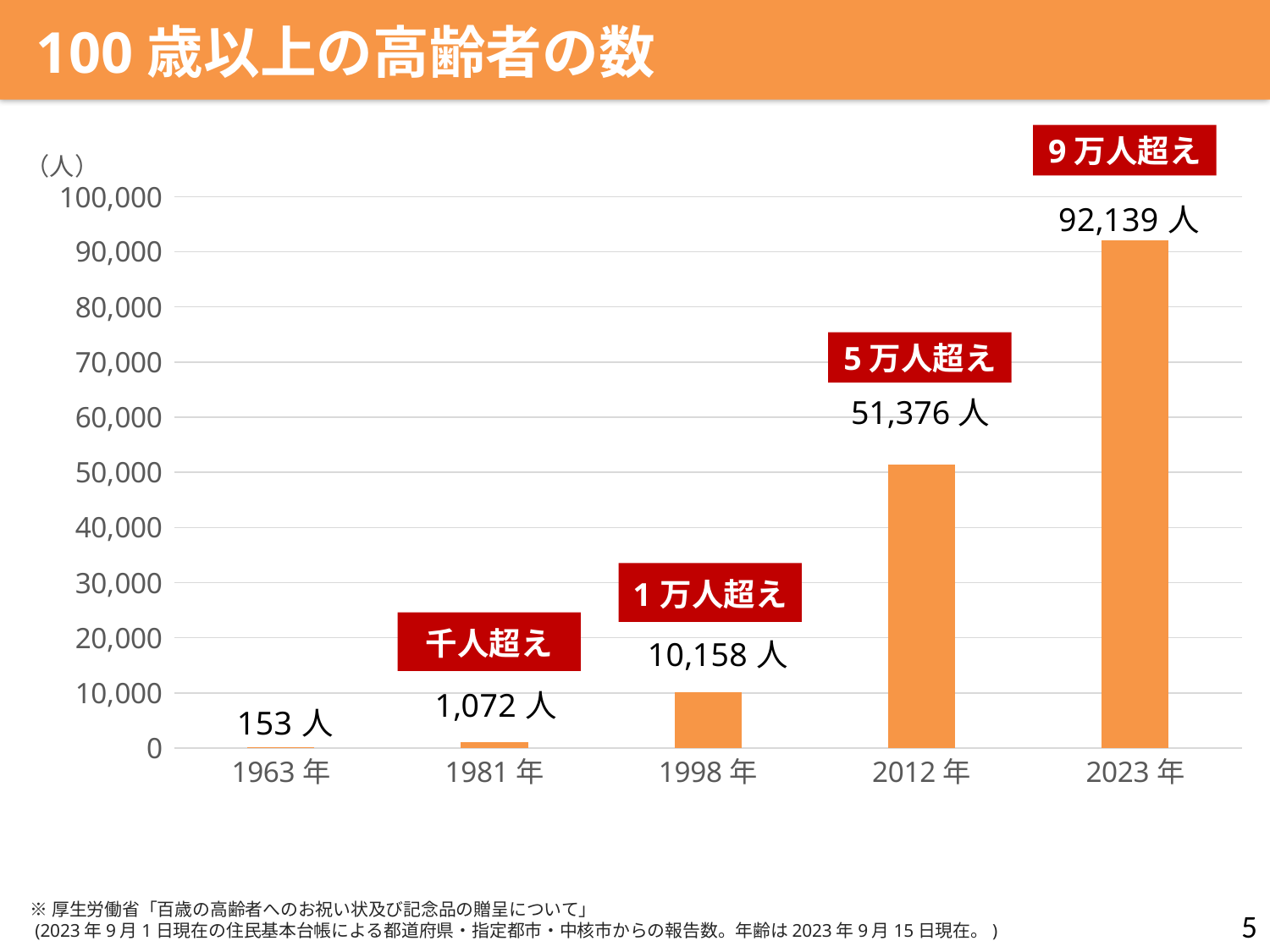
Do the values rise or fall from 1963年 to 2023年? rise What is the value for 1998年? 10,158 人 Which is larger, the value for 2012年 or the value for 1998年? 2012年 What kind of chart is this? bar chart What is the value for 1963年? 153 人 What is the difference between the values for 1998年 and 1981年? 9,086 人 How many years are shown on the x axis? 5 Which year has the lowest value? 1963年 Which year has the highest value? 2023年 What is the value for 2012年? 51,376 人 What is the value for 2023年? 92,139 人 What is the difference between the values for 2023年 and 2012年? 40,763 人